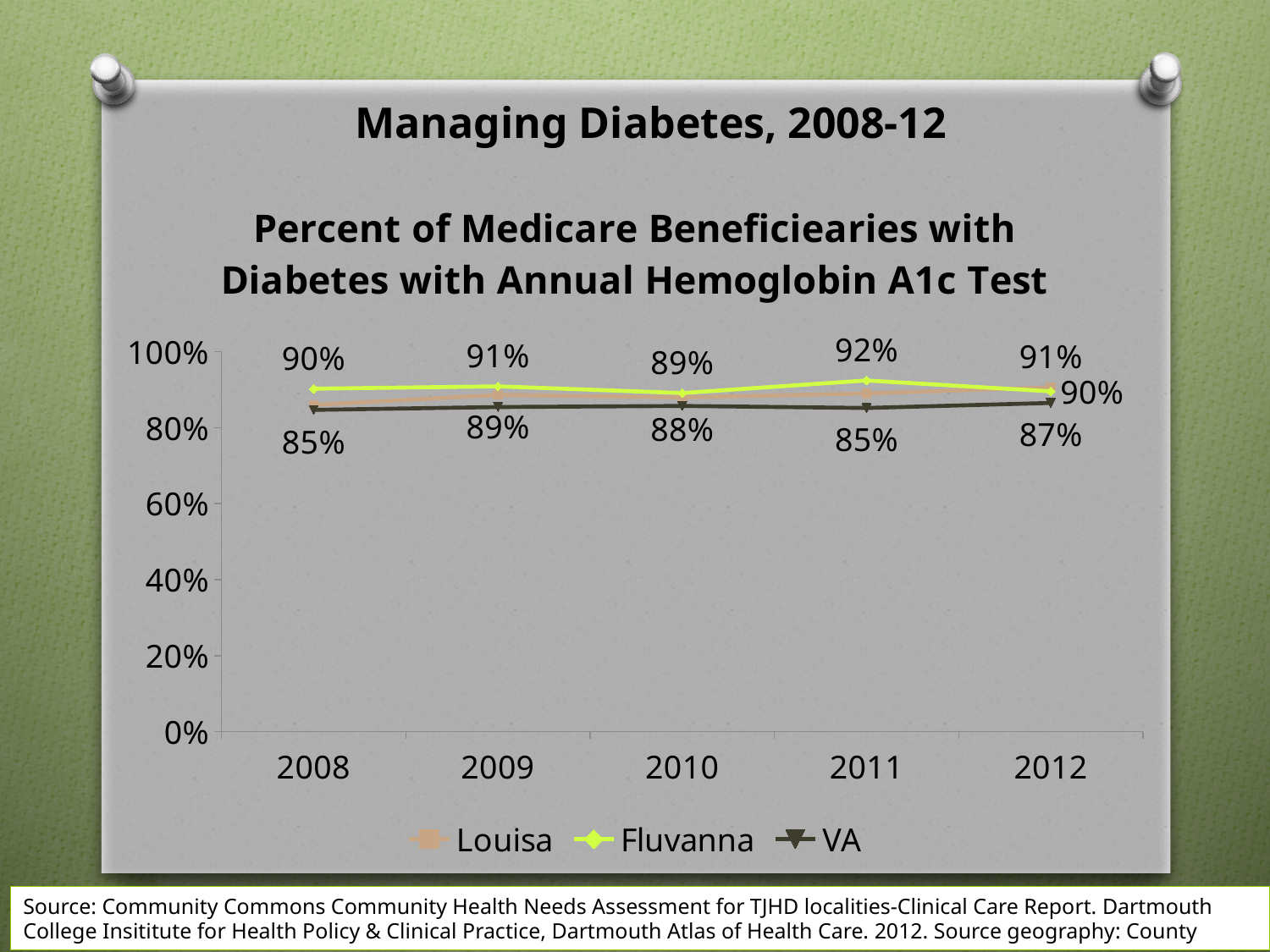
Which series are listed in the legend? Louisa, Fluvanna, VA What is the value for Fluvanna in 2011? 92% In which year is the Fluvanna value highest? 2011 In which year is the VA value highest? 2012 Is the value for Louisa in 2010 greater or less than 80%? greater What kind of chart is shown on the slide? line chart Which is larger in 2009, the Fluvanna value or the VA value? Fluvanna How many years are plotted along the x axis? 5 What is the value for VA in 2008? 85% How many series does the legend list? 3 What is the difference between the Fluvanna and VA values in 2011? 7 percentage points What is the value for VA in 2012? 87%